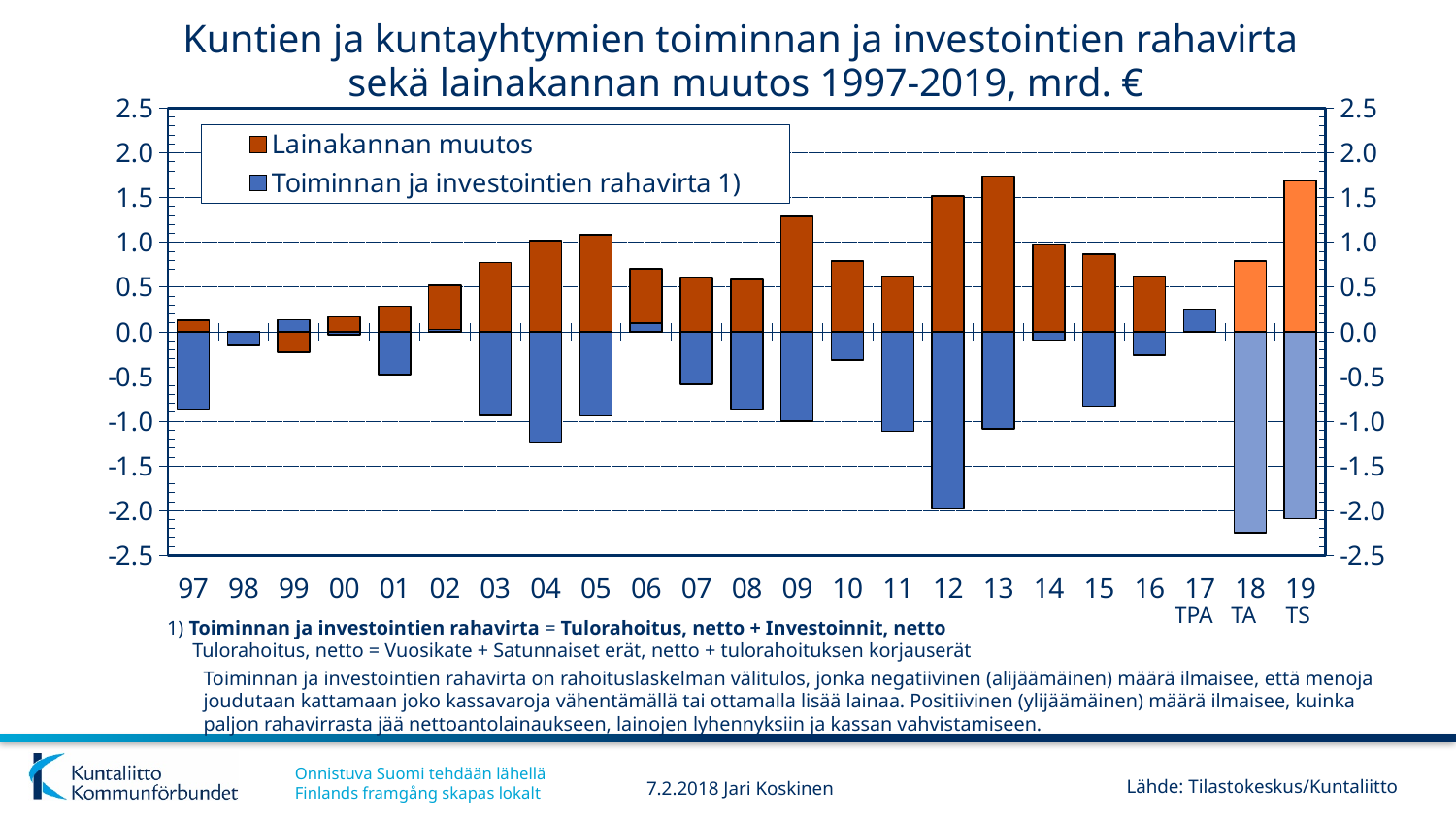
What is the unit given in the chart title? mrd. € Which year has the larger Lainakannan muutos value, 08 or 09? 09 Is the value of Lainakannan muutos for 12 greater or less than 1.0? greater Is the value of Toiminnan ja investointien rahavirta for 10 greater or less than -0.5? greater Is the value of Toiminnan ja investointien rahavirta for 18 greater or less than -2.0? less How many series does the legend list? 2 Which series is drawn in blue according to the legend? Toiminnan ja investointien rahavirta 1) How many years (categories) are shown on the x axis? 23 Which year has the larger Lainakannan muutos value, 12 or 13? 13 What kind of chart is shown on the slide? bar chart